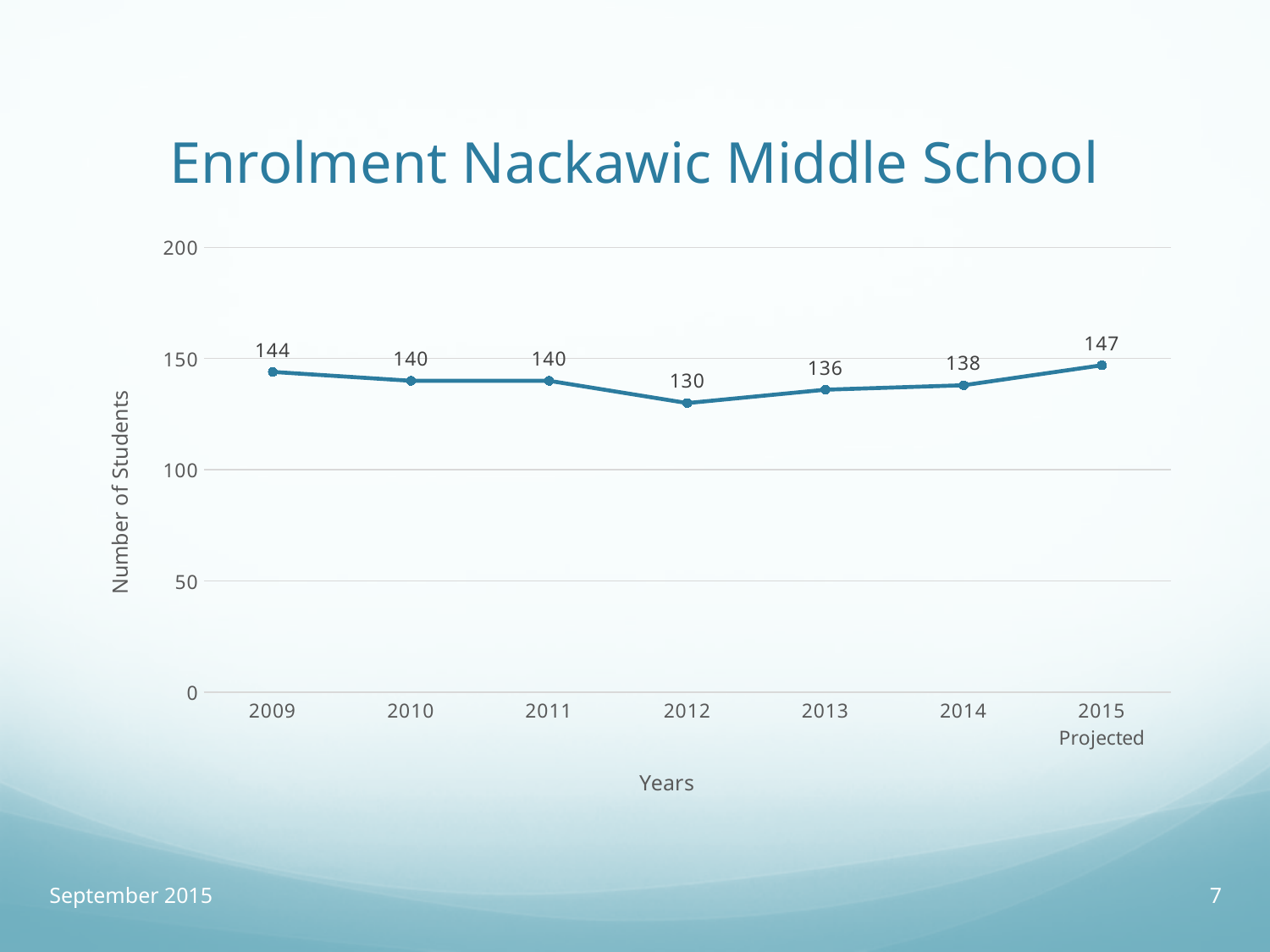
What is the enrolment value for 2009? 144 What is the enrolment value for 2012? 130 How many years are plotted on the chart? 7 What is the title of the chart? Enrolment Nackawic Middle School What kind of chart is shown on the slide? line chart Is the enrolment value for 2012 greater or less than 150? less What is the projected enrolment value for 2015? 147 Which is larger, the enrolment in 2013 or in 2014? 2014 What is the difference between the enrolment in 2009 and 2012? 14 What is the difference between the projected 2015 enrolment and the 2014 enrolment? 9 Which year has the highest enrolment? 2015 Projected Which year has the lowest enrolment? 2012